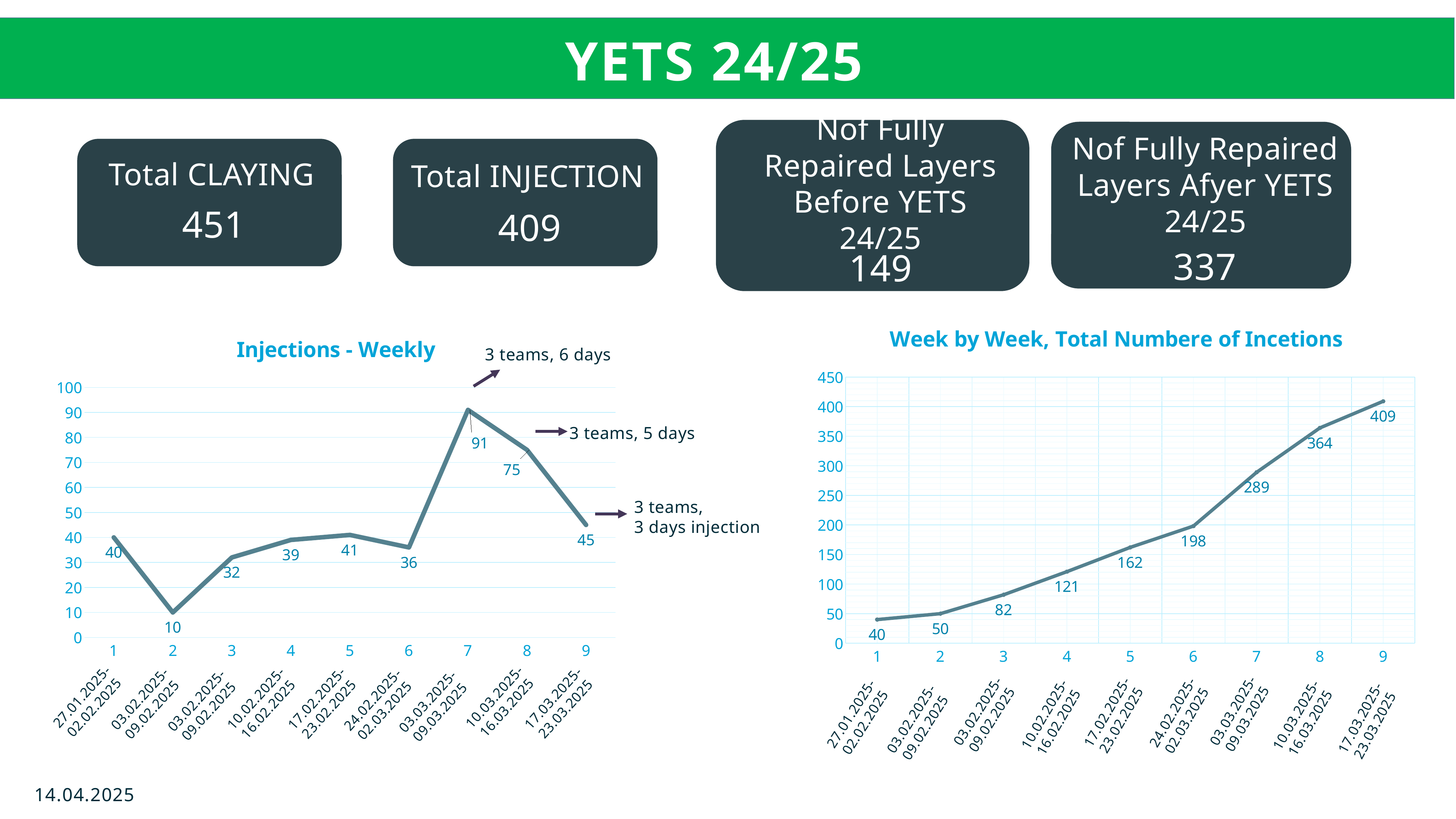
In the 'Injections - Weekly' chart, which week has the highest value? 7 In the 'Week by Week, Total Numbere of Incetions' chart, do the values rise or fall from week 1 to week 9? rise In the 'Week by Week, Total Numbere of Incetions' chart, is the value for week 4 greater or less than 150? less What kind of chart is the 'Injections - Weekly' chart? line chart In the 'Week by Week, Total Numbere of Incetions' chart, what is the value for week 9? 409 In the 'Injections - Weekly' chart, how many weeks are plotted on the x axis? 9 In the 'Injections - Weekly' chart, what is the value for week 7? 91 In the 'Injections - Weekly' chart, is the value for week 9 greater or less than 50? less In the 'Injections - Weekly' chart, which week has the lowest value? 2 In the 'Week by Week, Total Numbere of Incetions' chart, what is the difference between the values for week 8 and week 7? 75 In the 'Week by Week, Total Numbere of Incetions' chart, what is the value for week 6? 198 In the 'Injections - Weekly' chart, what is the difference between the values for week 7 and week 8? 16